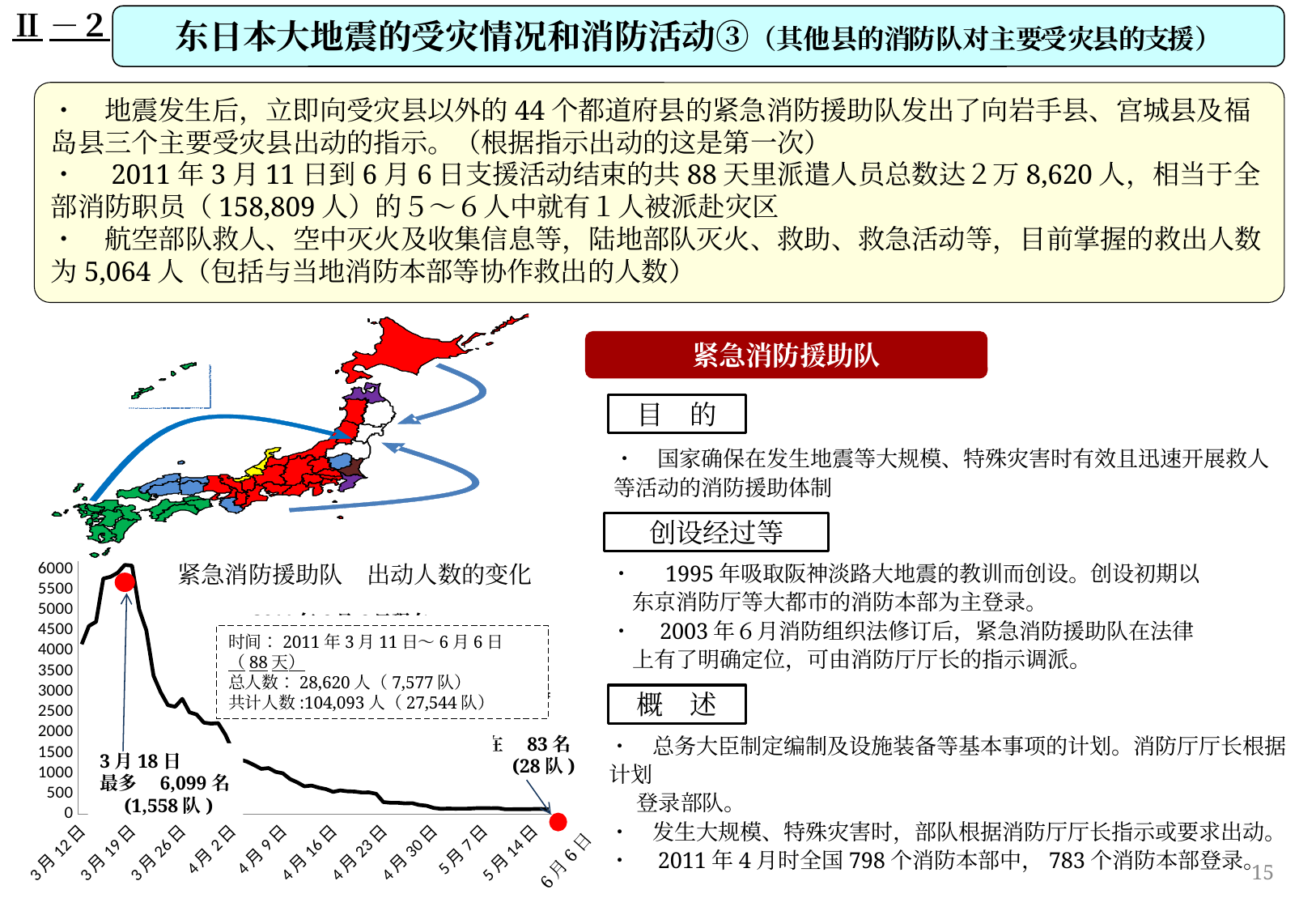
What kind of chart is shown at the bottom left of the slide? line chart Which date has the larger value on the chart, 3月19日 or 5月14日? 3月19日 On which date does the chart show the maximum number of dispatched personnel? 3月18日 How many teams (队) are shown for 6月6日 on the chart? 28队 Is the value for 5月7日 greater or less than 500? less After the peak on 3月18日, do the values on the chart rise or fall along the x axis? fall What is the number of dispatched personnel shown for 6月6日? 83名 How many teams (队) were dispatched at the peak on 3月18日 according to the chart annotation? 1,558队 What is the maximum number of dispatched personnel shown on the chart (3月18日)? 6,099名 Is the value for 3月12日 greater or less than 3000? greater What is the difference between the peak value on 3月18日 (6,099名) and the value on 6月6日 (83名)? 6,016 What is the title of the chart at the bottom left of the slide? 紧急消防援助队 出动人数的变化